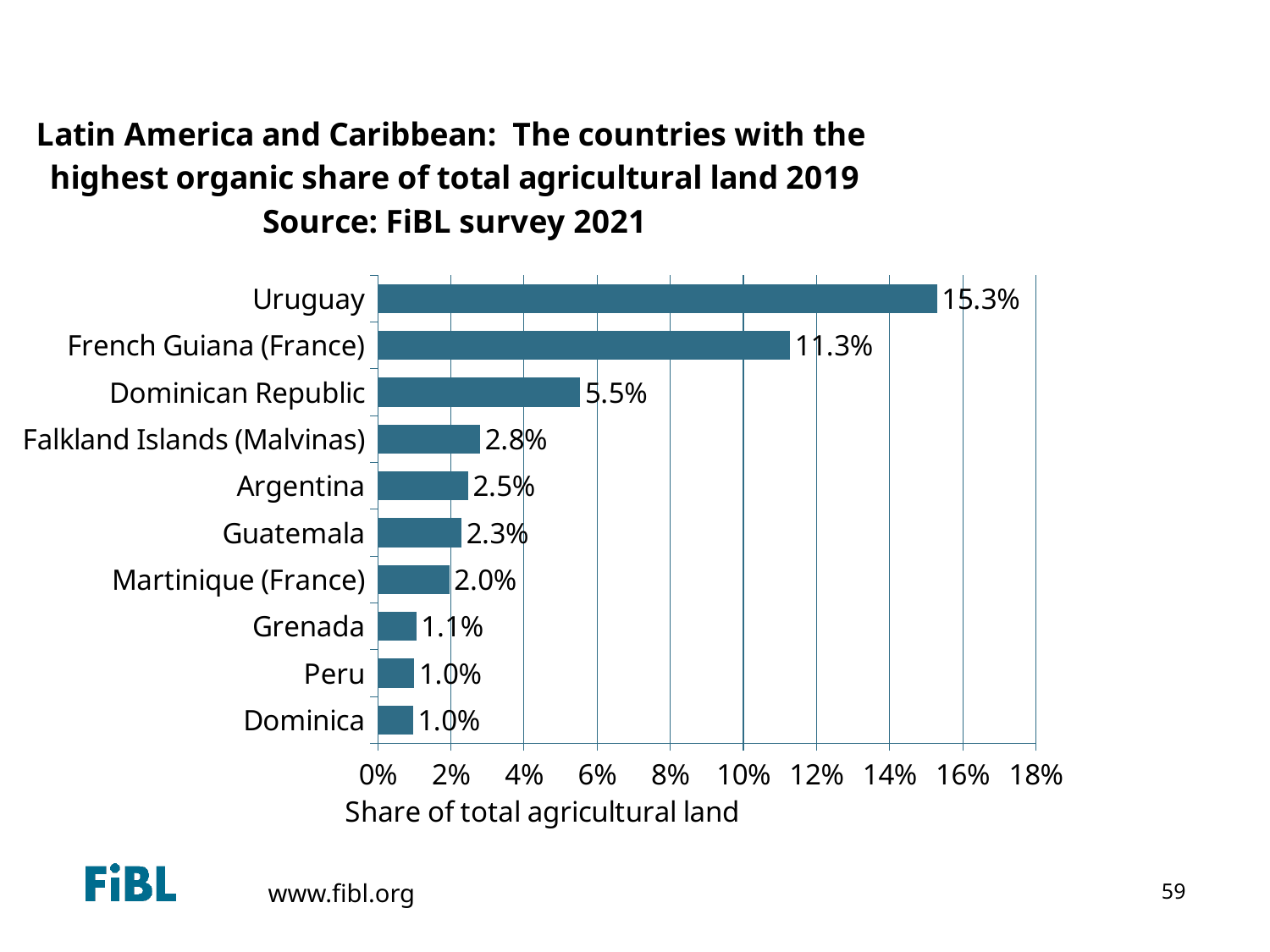
Which country has the highest organic share of total agricultural land? Uruguay What is the organic share of total agricultural land for Uruguay? 15.3% What is the difference between the values for Uruguay and French Guiana (France)? 4.0% What is the label of the horizontal axis? Share of total agricultural land What is the difference between the values for Falkland Islands (Malvinas) and Argentina? 0.3% What kind of chart is shown on the slide? Bar chart What is the organic share of total agricultural land for Dominican Republic? 5.5% Which has a larger organic share, Dominican Republic or Martinique (France)? Dominican Republic What is the value shown for Guatemala? 2.3% What is the source given in the chart title? FiBL survey 2021 How many countries are shown in the chart? 10 Is the value for French Guiana (France) greater or less than 10%? greater